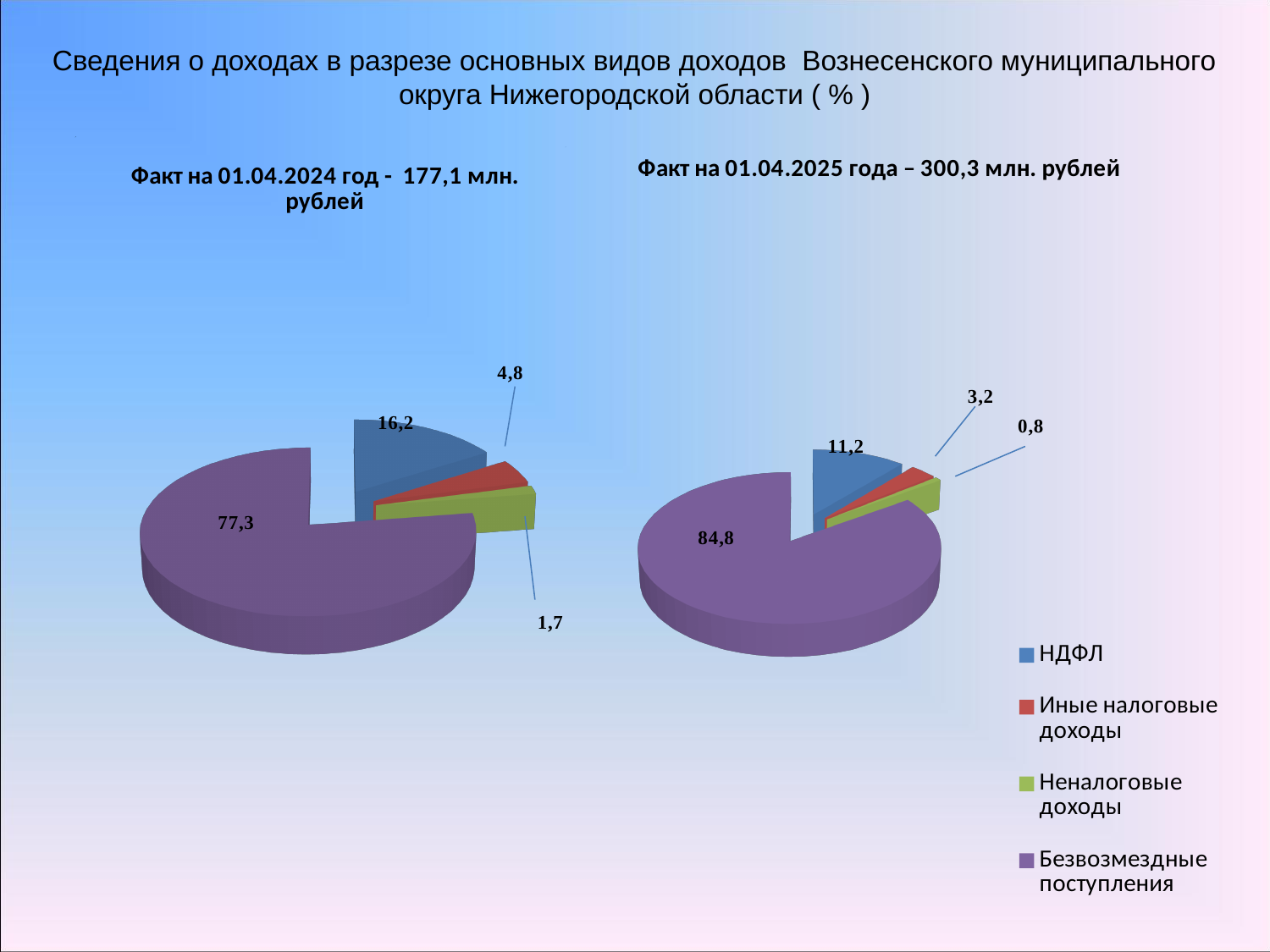
What type of chart is used on this slide? Pie chart Which is larger: Иные налоговые доходы on the left chart (01.04.2024) or on the right chart (01.04.2025)? Left chart (01.04.2024), 4,8 On the left pie chart (Факт на 01.04.2024 год), which category has the largest share? Безвозмездные поступления What colour represents Безвозмездные поступления in the legend? Purple What total amount in million rubles is stated in the title of the right chart (01.04.2025)? 300,3 млн. рублей On the left pie chart (Факт на 01.04.2024 год), what is the value for Неналоговые доходы? 1,7 On the left pie chart (Факт на 01.04.2024 год), what is the value for НДФЛ? 16,2 On the right pie chart (Факт на 01.04.2025 года), which category has the smallest share? Неналоговые доходы How many categories does the legend list? 4 What is the difference between the НДФЛ value on the left chart (01.04.2024) and on the right chart (01.04.2025)? 5,0 On the right pie chart (Факт на 01.04.2025 года), what is the value for Безвозмездные поступления? 84,8 On the right pie chart (Факт на 01.04.2025 года), what is the value for Иные налоговые доходы? 3,2